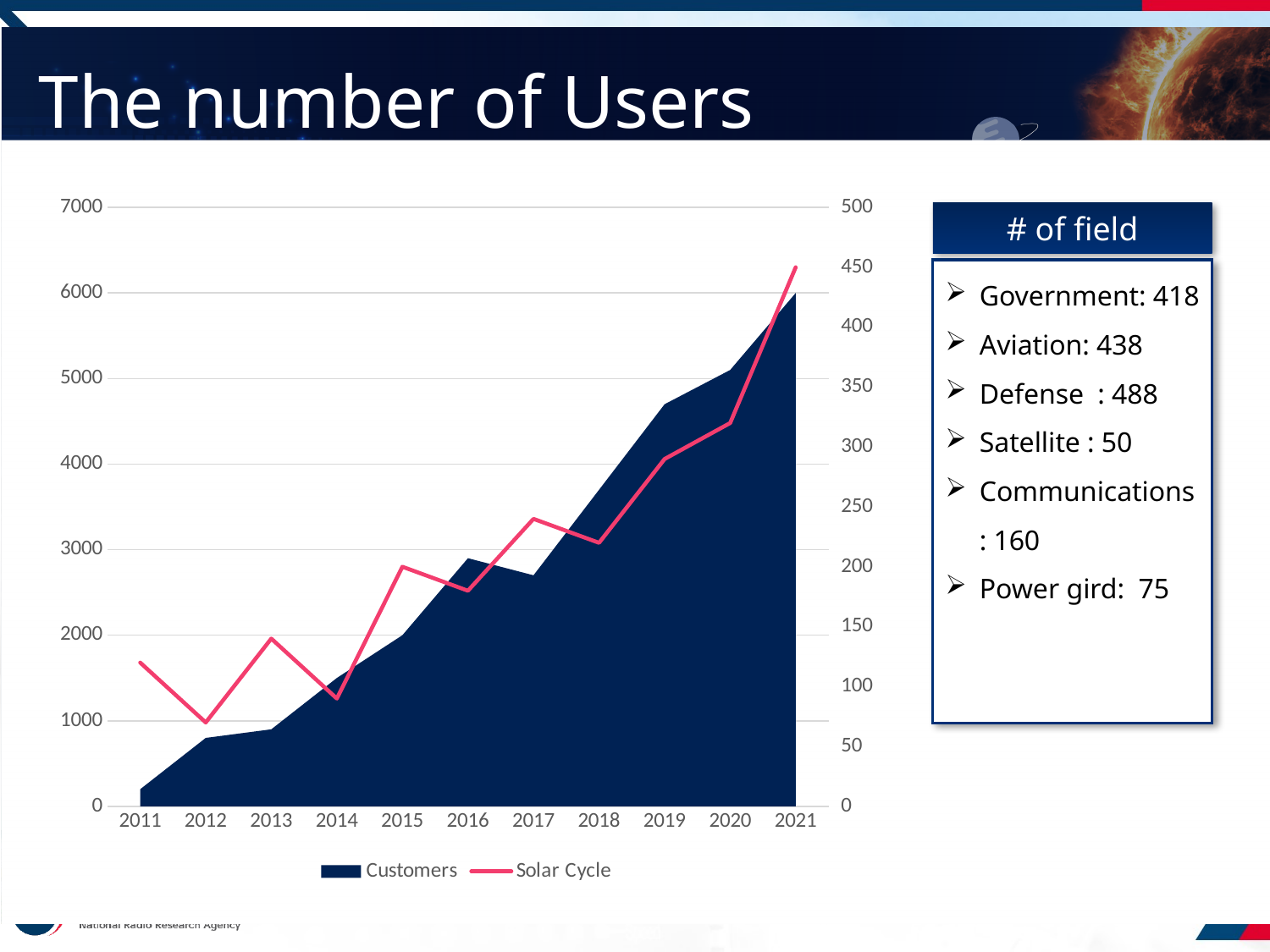
What kind of chart is used to show the Customers series? Area chart How many series does the chart legend list? 2 Do the Customers values generally rise or fall from 2011 to 2021? rise In which year is the Customers value highest? 2021 How many years are shown along the x axis of the chart? 11 What are the two series named in the chart legend? Customers and Solar Cycle Is the Customers value for 2021 greater or less than 5000? greater Is the Customers value for 2011 greater or less than 1000? less Which year has the larger Customers value, 2016 or 2017? 2016 In which year does the Solar Cycle line reach its highest value? 2021 Is the Solar Cycle value for 2021 greater or less than 400 on the right axis? greater In which year is the Customers value lowest? 2011